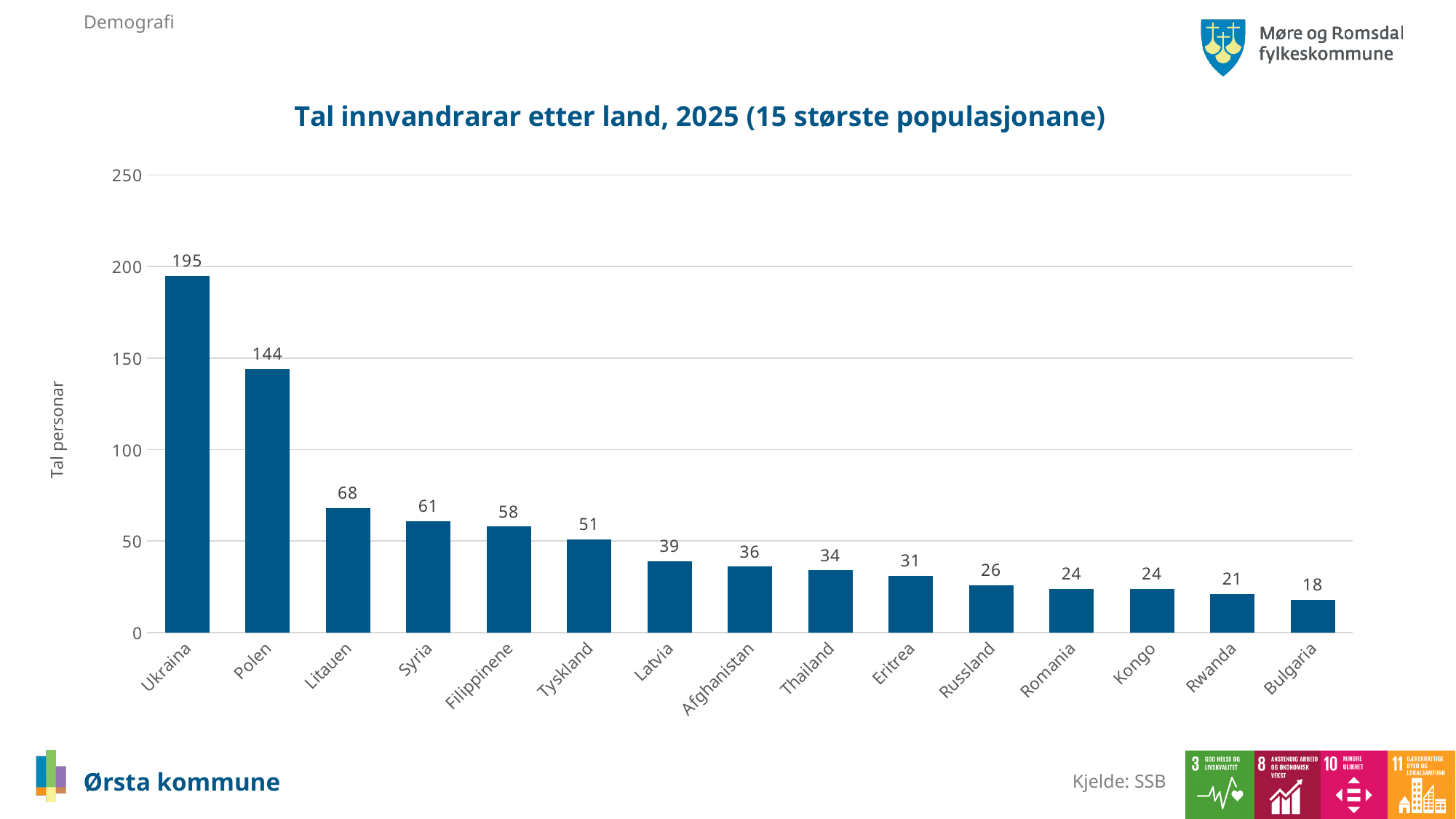
What is the value for Syria? 61 What is the value for Eritrea? 31 Which country has the highest value? Ukraina What is the difference between the values for Ukraina and Polen? 51 What kind of chart is this? Bar chart Do the values rise or fall from left to right along the x axis? Fall How many countries are shown in the chart? 15 What is the title of the chart? Tal innvandrarar etter land, 2025 (15 største populasjonane) Which is larger, the value for Latvia or the value for Thailand? Latvia Which country has the lowest value? Bulgaria What is the difference between the values for Litauen and Tyskland? 17 What is the value for Ukraina? 195